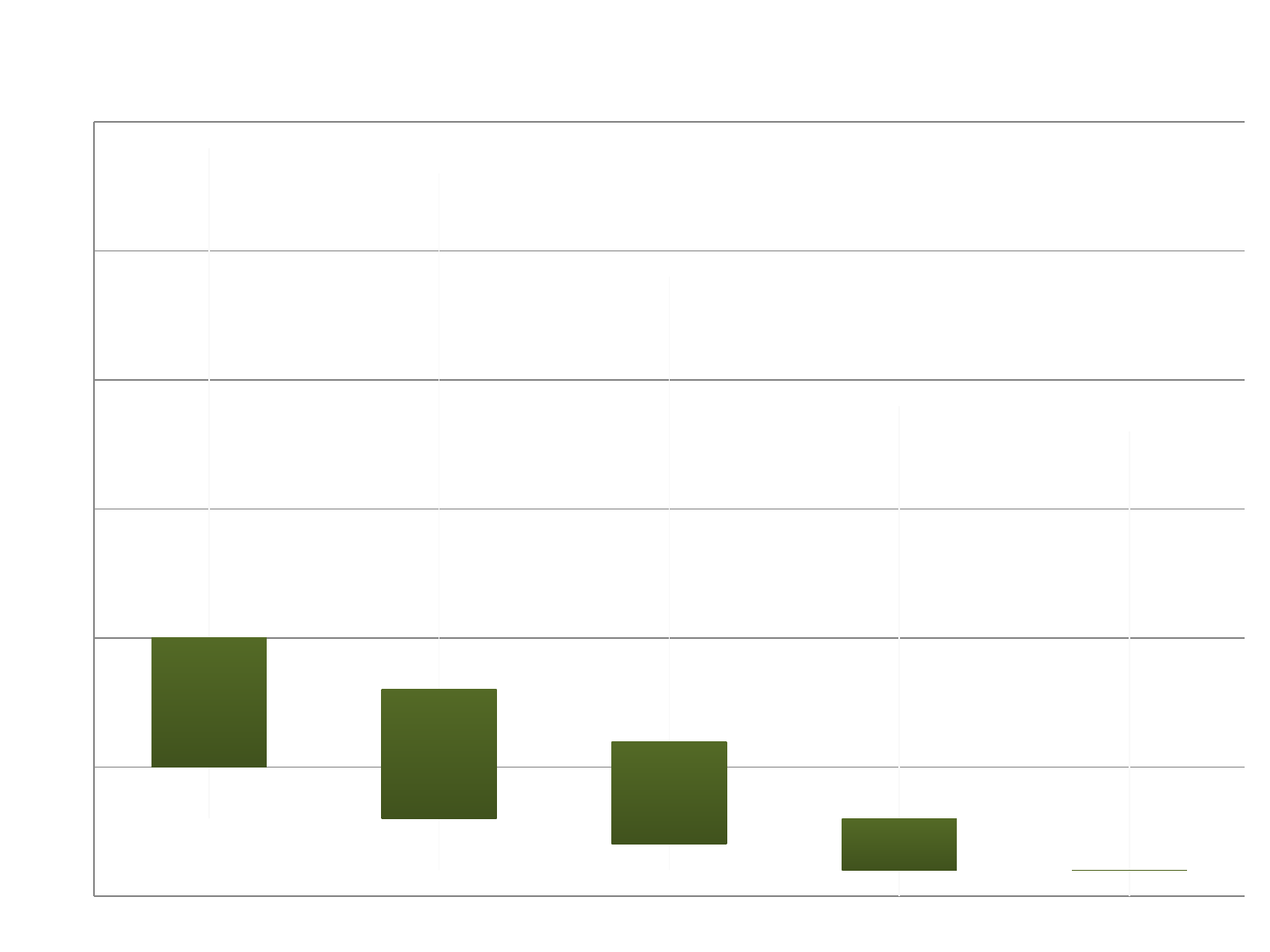
What kind of chart is shown on the slide? bar chart What colour are the bars in the chart? green Do the bars rise or fall from left to right across the chart? fall